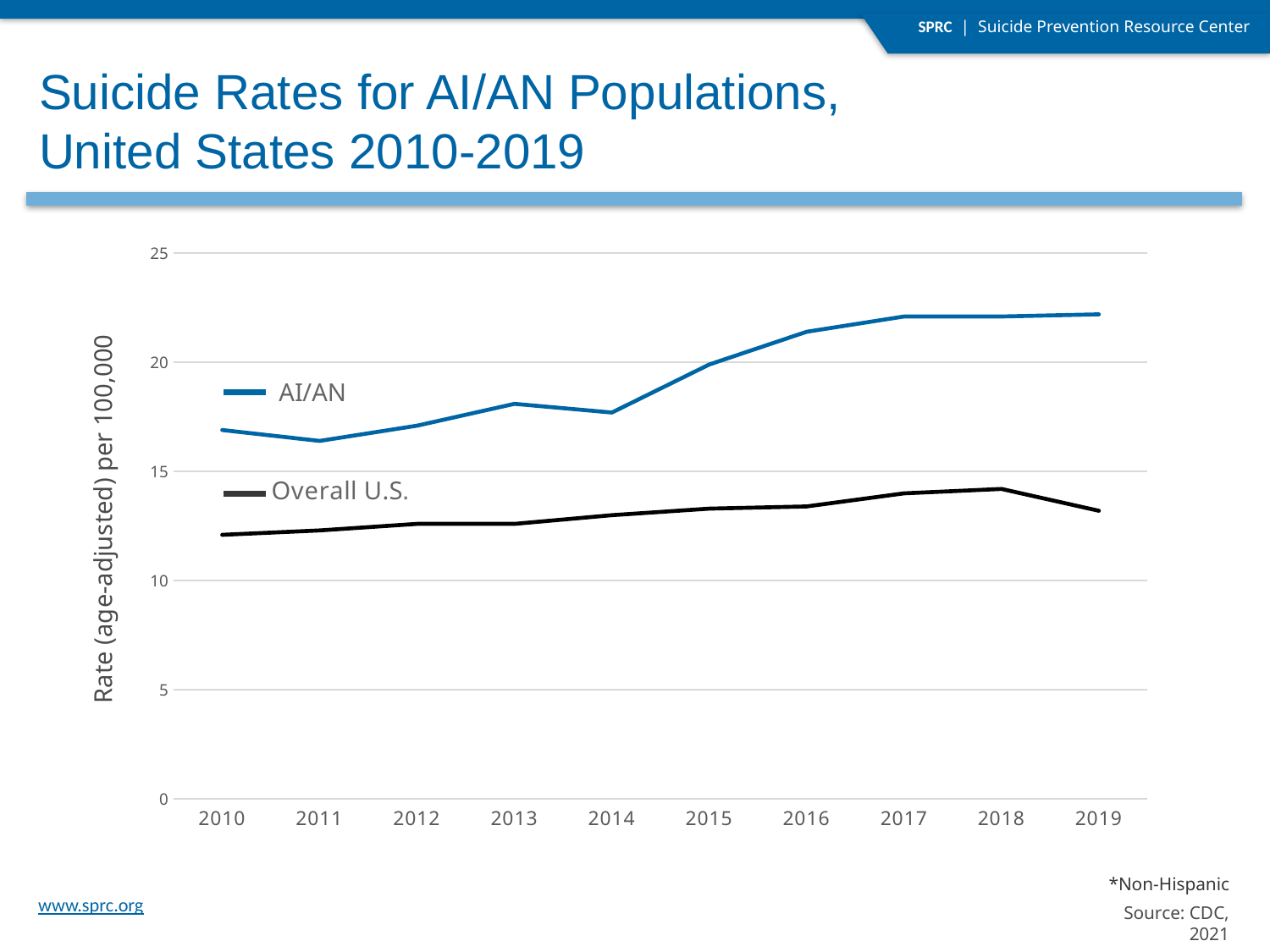
Is the AI/AN value for 2010 greater or less than 20? less What is the label on the vertical axis? Rate (age-adjusted) per 100,000 How many series does the chart's legend list? 2 What kind of chart is shown on the slide? Line chart Does the AI/AN rate generally rise or fall from 2010 to 2019? Rise Is the AI/AN value for 2019 greater or less than 20? greater What are the two series named in the legend? AI/AN and Overall U.S. In which year is the Overall U.S. rate highest? 2018 Which series has the higher value in 2019, AI/AN or Overall U.S.? AI/AN Is the Overall U.S. value for 2018 greater or less than 15? less How many years are plotted along the x axis? 10